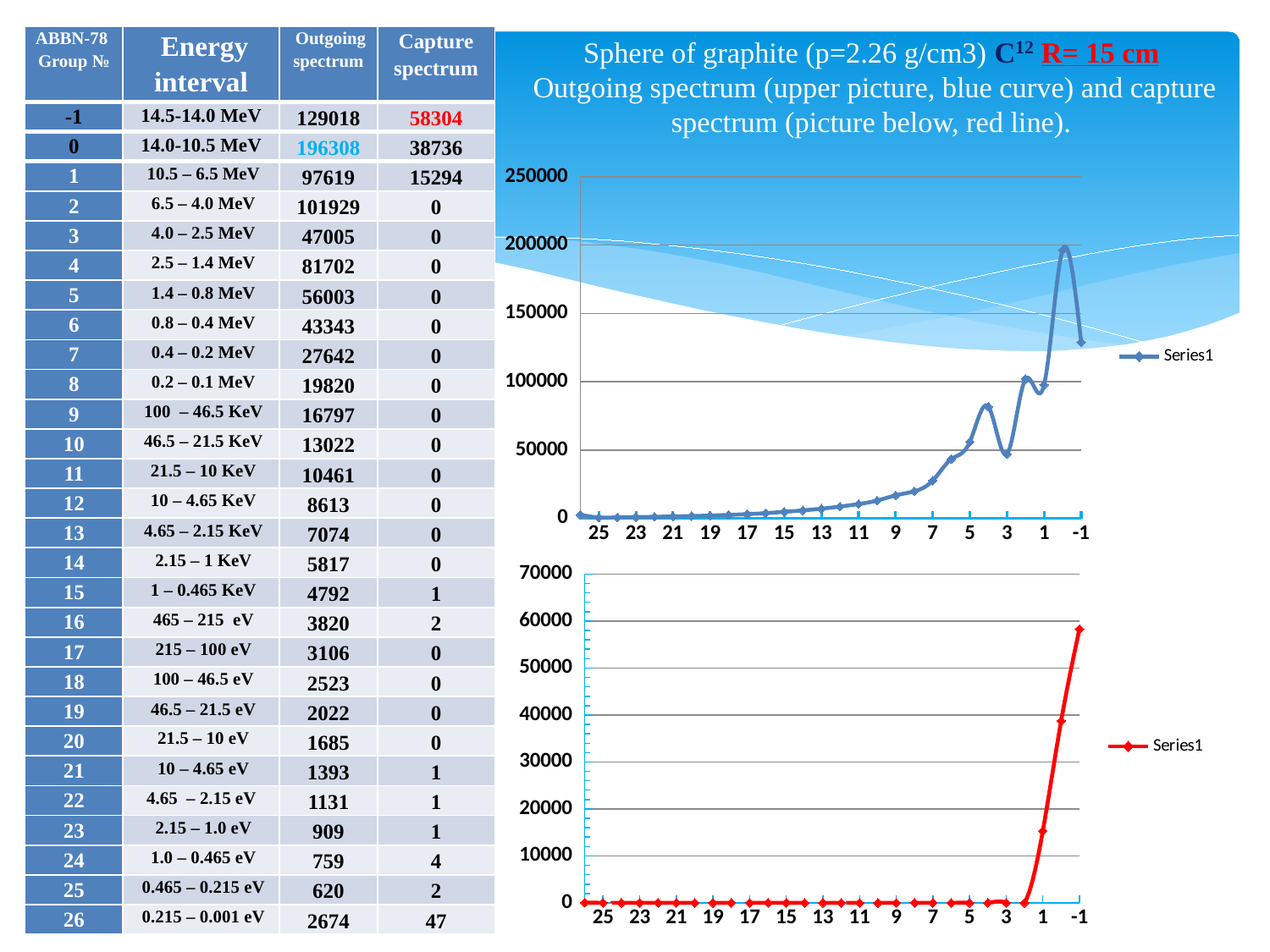
In the lower chart, is the value at x = -1 greater or less than 50000? greater In the lower chart, is the value at x = 1 greater or less than 10000? greater In the lower chart, do the values generally rise or fall moving from left to right along the x axis? rise In the upper chart, is the value at x = 7 greater or less than 50000? less In the upper chart, at which x-axis label does the curve reach its highest value? 0 How many series does the legend of the upper chart list? 1 What colour is the line in the lower chart? red What kind of chart is the lower chart on the slide? line chart What kind of chart is the upper chart on the slide? line chart In the upper chart, which is larger: the value at x = 0 or the value at x = -1? x = 0 In the lower chart, at which x-axis label does the curve reach its highest value? -1